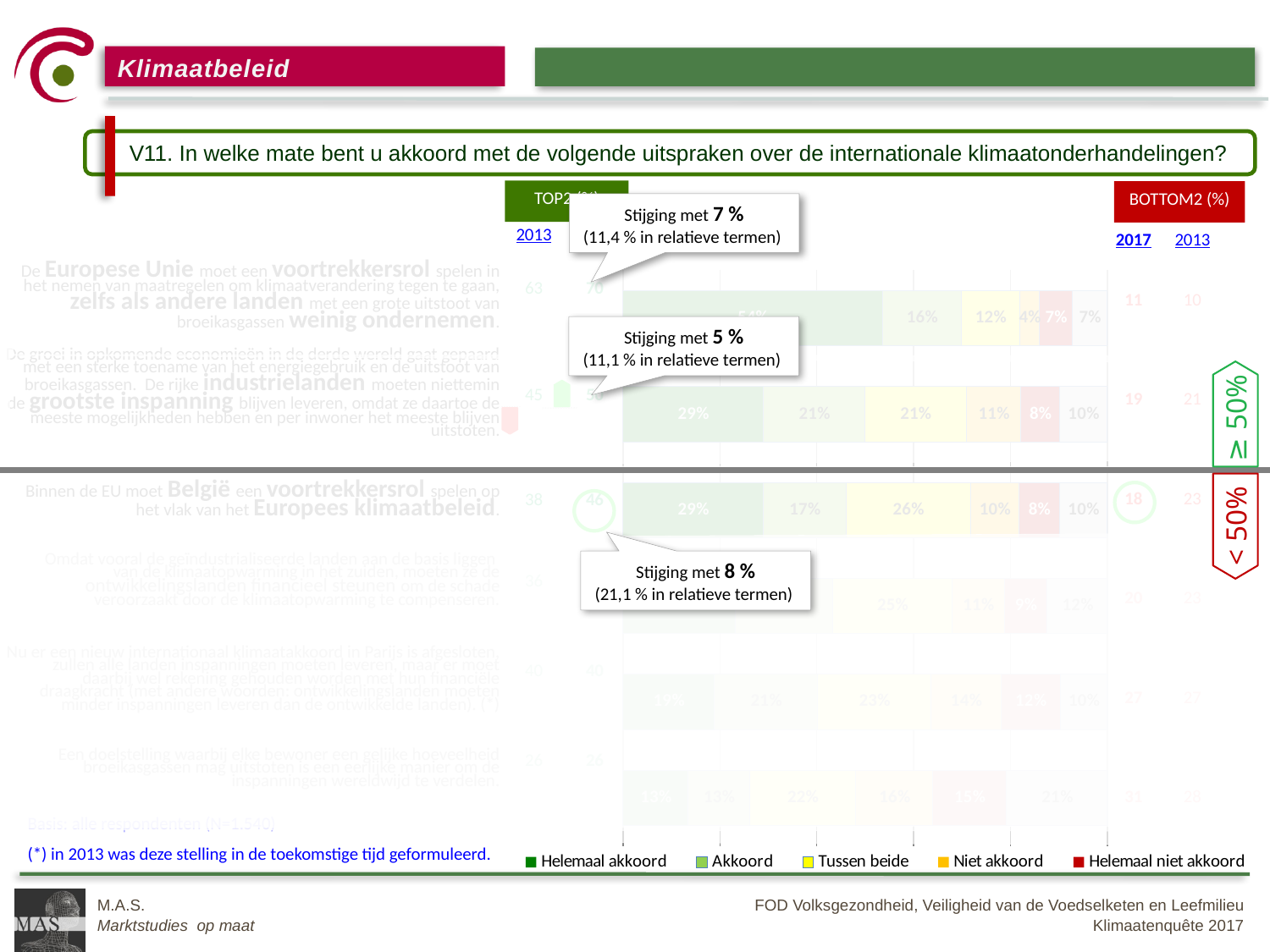
What relative increase is given in the callout that says 'Stijging met 5 %'? 11,1 % What relative increase is given in the callout that says 'Stijging met 7 %'? 11,4 % How many series does the chart legend list? 5 What relative increase is given in the callout that says 'Stijging met 8 %'? 21,1 % What is the first entry in the chart legend? Helemaal akkoord What is the TOP2 (%) value for 2013 for the statement about the Europese Unie playing a voortrekkersrol? 63 What is the last entry in the chart legend? Helemaal niet akkoord What is the BOTTOM2 (%) value for 2017 for the statement 'Binnen de EU moet België een voortrekkersrol spelen'? 18 Which of the three callouts shows the largest absolute increase: 7 %, 5 % or 8 %? 8 % According to the top callout, by how many percentage points did the TOP2 score rise for the first statement? 7 % What is the BOTTOM2 (%) value for 2013 for the statement 'Binnen de EU moet België een voortrekkersrol spelen'? 23 What kind of chart is shown on the slide? bar chart